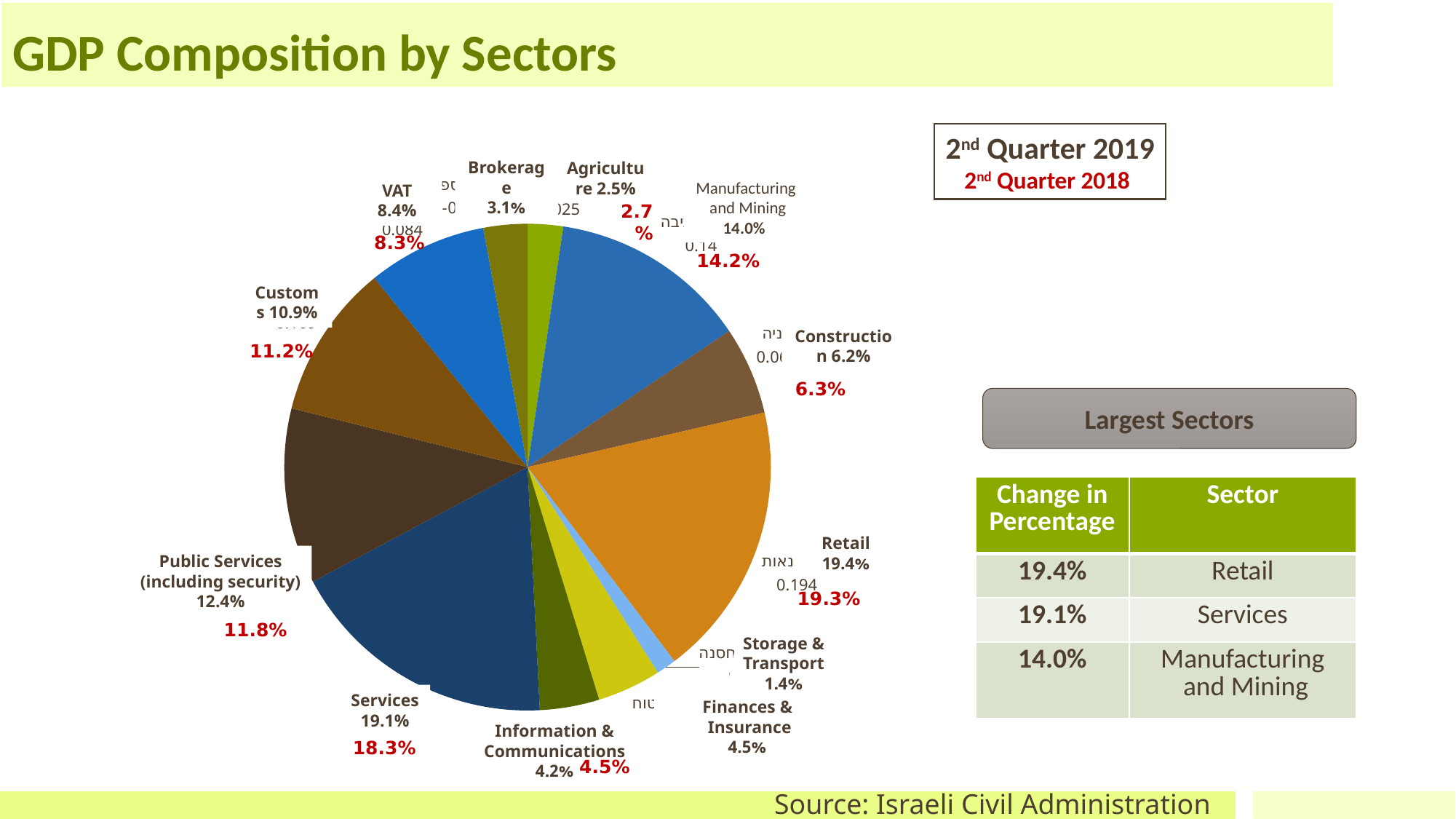
What is the 2nd Quarter 2018 share of GDP for Services (shown in red)? 18.3% What is the 2nd Quarter 2019 share of GDP for Public Services (including security)? 12.4% What is the 2nd Quarter 2019 share of GDP for Retail? 19.4% What is the difference between the Customs share in 2nd Quarter 2018 (11.2%) and 2nd Quarter 2019 (10.9%)? 0.3% Which sector has the largest share of GDP in the 2nd Quarter 2019? Retail What is the difference between the 2nd Quarter 2019 shares of Retail and Services? 0.3% Which sector has a larger 2nd Quarter 2019 share: Customs or VAT? Customs What type of chart is shown on the slide? Pie chart How many sectors are shown in the pie chart? 12 Which sector has the smallest share of GDP in the 2nd Quarter 2019? Storage & Transport What is the 2nd Quarter 2019 share of GDP for Manufacturing and Mining? 14.0% According to the Largest Sectors table, which sector is listed with 14.0%? Manufacturing and Mining